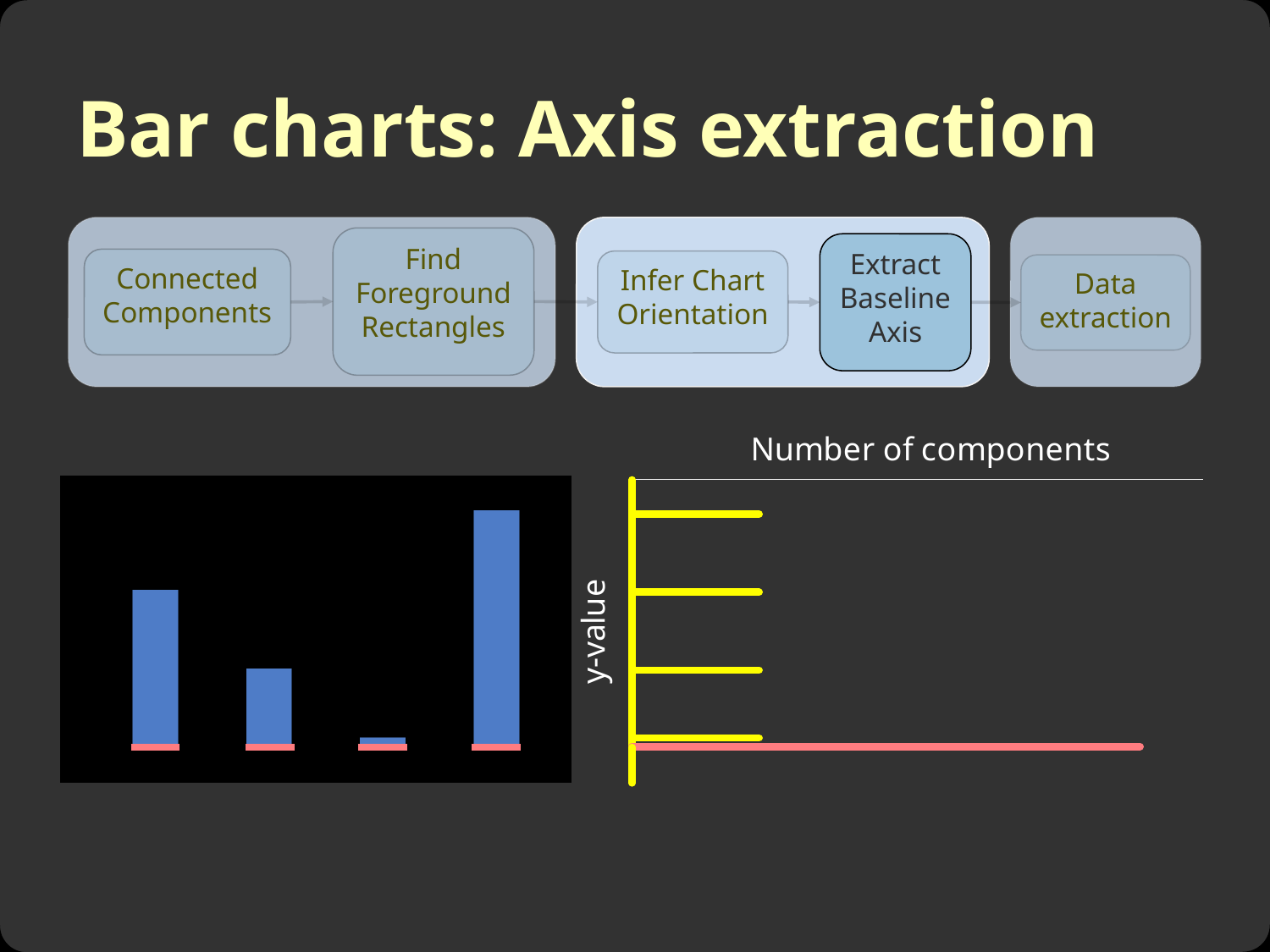
What colour are the bars in the bar chart on the left of the slide? blue What is the label on the vertical axis of the diagram on the right of the slide? y-value In the bar chart on the left of the slide, which bar is the shortest, counting from the left? the third bar In the bar chart on the left of the slide, which bar is the tallest, counting from the left? the fourth (rightmost) bar In the bar chart on the left of the slide, do the bar heights fall steadily from left to right? no What kind of chart is shown on the left of the slide? bar chart In the bar chart on the left of the slide, which is taller: the first bar or the second bar? the first bar How many bars does the bar chart on the left of the slide contain? 4 In the bar chart on the left of the slide, which is taller: the second bar or the third bar? the second bar